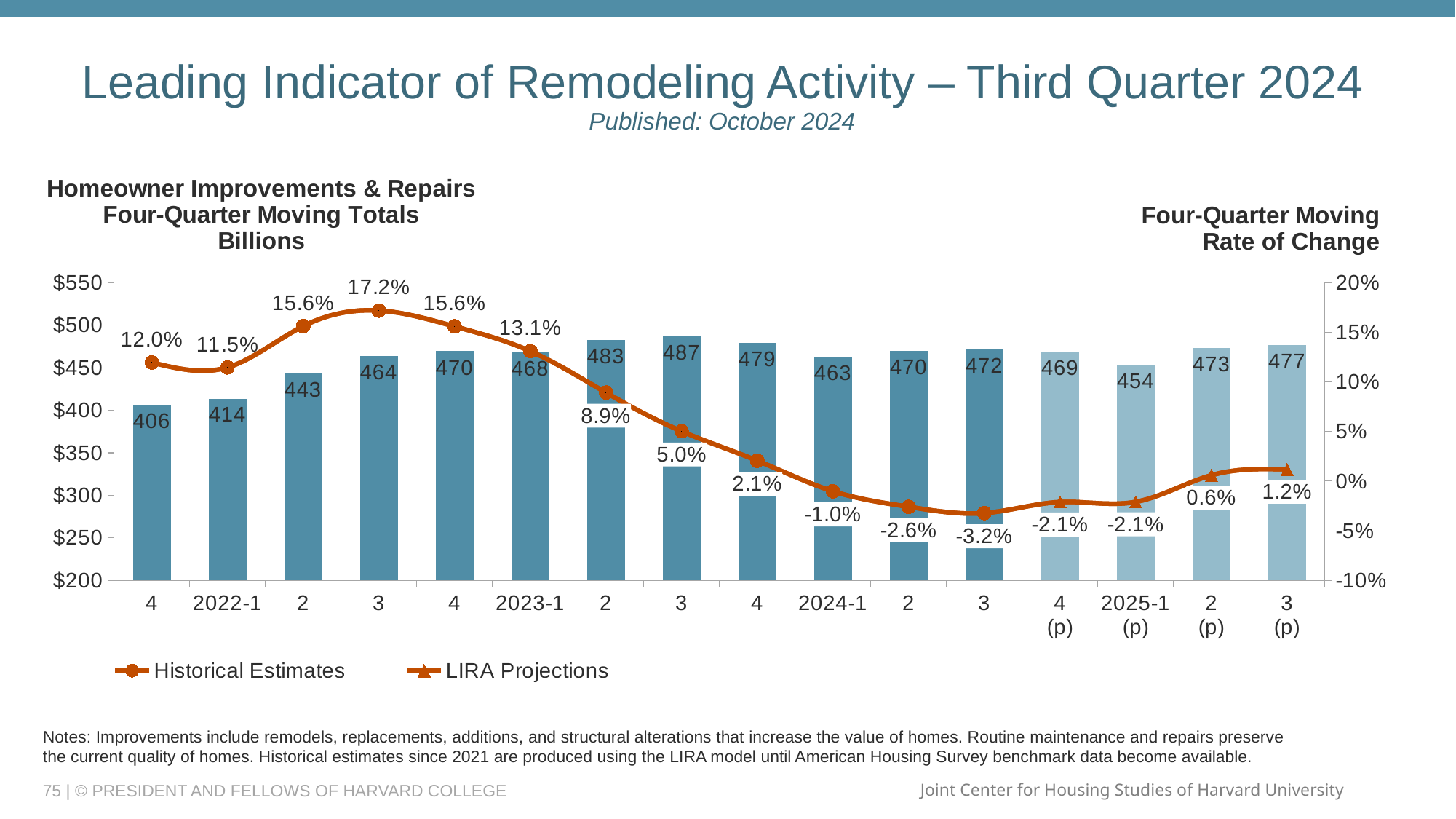
What is the projected four-quarter moving total for 2025-1 (p)? 454 What is the projected rate of change for 2025-3 (p)? 1.2% Which is larger, the four-quarter moving total for 2024-2 or for 2025-2 (p)? 2025-2 (p) Which quarter has the highest four-quarter moving total bar? 2023-3 (487) What is the four-quarter moving rate of change for 2022-3? 17.2% How many bars are plotted on the chart? 16 What are the two series named in the legend? Historical Estimates and LIRA Projections What is the four-quarter moving total for 2024-1? 463 Does the rate of change line rise or fall from 2022-3 to 2024-3? fall Which quarter has the lowest four-quarter moving rate of change? 2024-3 (-3.2%) What is the difference between the four-quarter moving totals for 2023-2 and 2022-1? 69 How many series does the legend list? 2